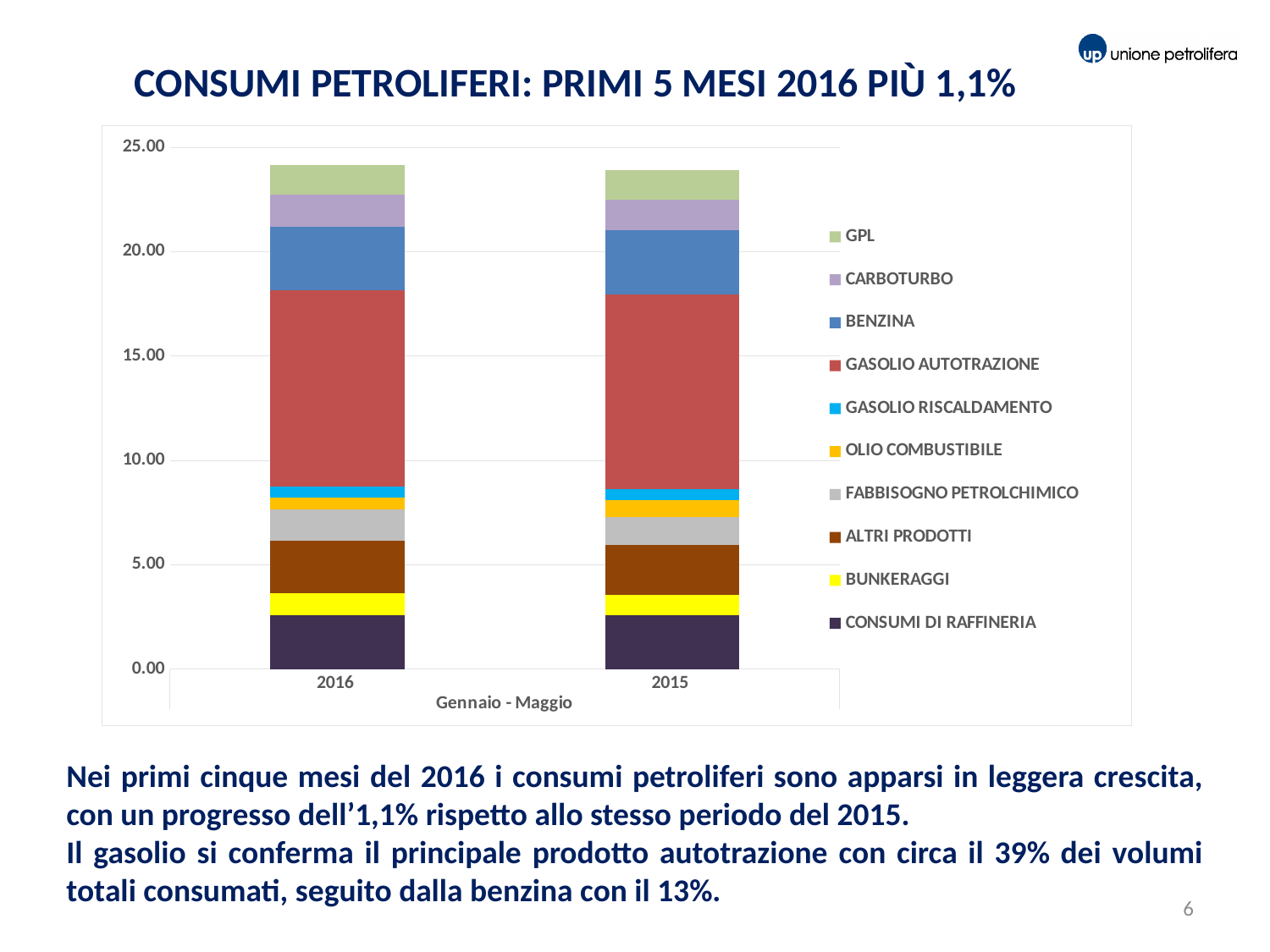
How many bars (categories) are plotted on the x axis? 2 Is the total height of the 2016 bar greater or less than 20? greater Is the top of the GASOLIO AUTOTRAZIONE segment in the 2016 bar greater or less than 15? greater Which series is listed first (at the top) in the legend? GPL Which series forms the largest segment of the 2016 bar? GASOLIO AUTOTRAZIONE Which series is listed last (at the bottom) in the legend? CONSUMI DI RAFFINERIA Is the total height of the 2015 bar greater or less than 25? less What label is shown under the x axis of the chart? Gennaio - Maggio What kind of chart is shown on the slide? Stacked bar chart Which series forms the largest segment of the 2015 bar? GASOLIO AUTOTRAZIONE How many series does the legend list? 10